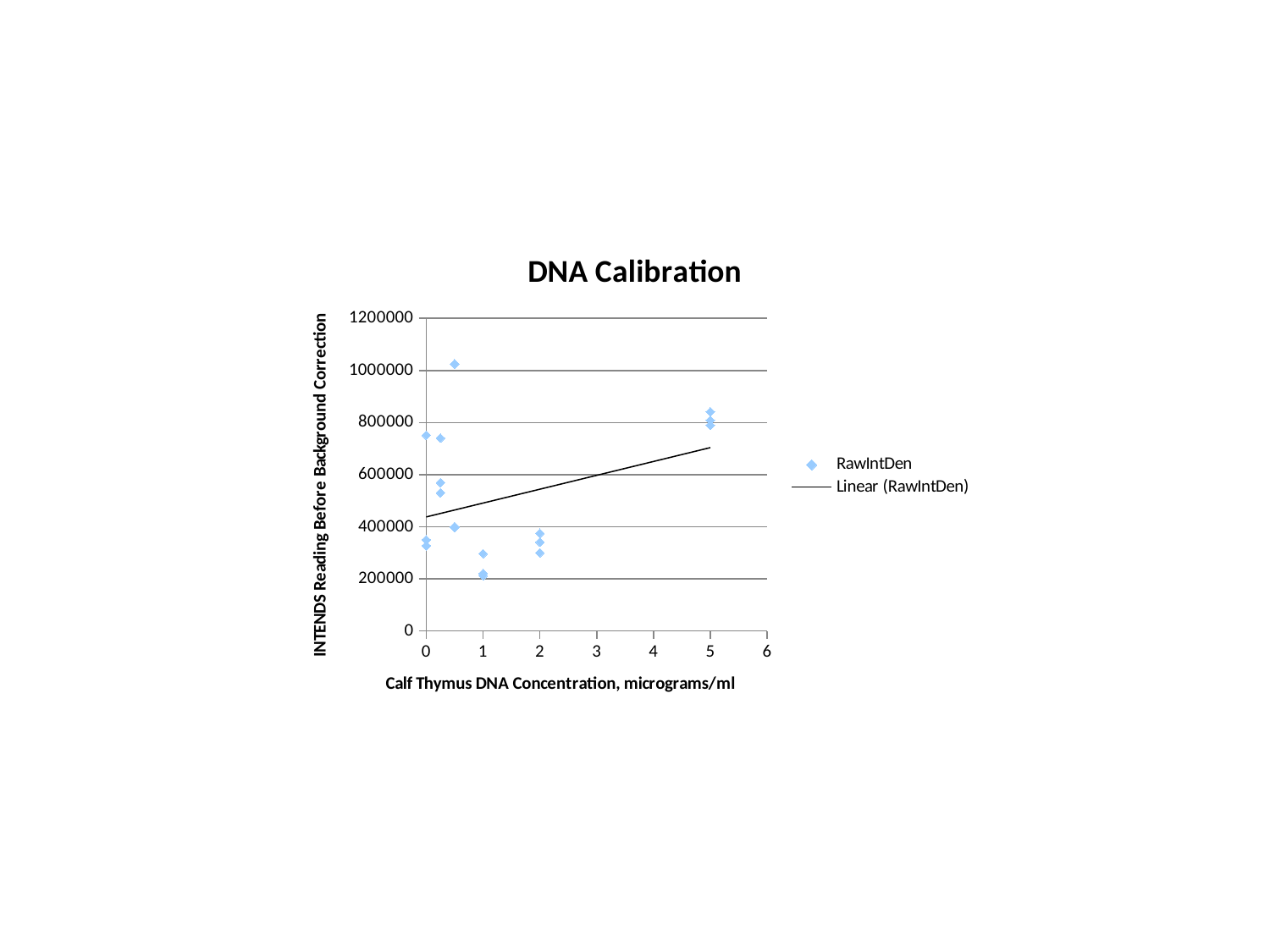
What is the title of the chart? DNA Calibration Is the highest RawIntDen point at a concentration of 5 micrograms/ml greater or less than 800000? greater What kind of chart is shown on the slide? scatter chart Are the RawIntDen points at a concentration of 1 microgram/ml greater or less than 400000? less Are the RawIntDen points at a concentration of 5 micrograms/ml greater or less than 600000? greater How many entries does the chart legend list? 2 What is the maximum value shown on the y axis? 1200000 What is the label of the x axis? Calf Thymus DNA Concentration, micrograms/ml Does the linear trendline rise or fall as the DNA concentration increases? rises At which concentration does the highest RawIntDen point occur, 0.5 or 5 micrograms/ml? 0.5